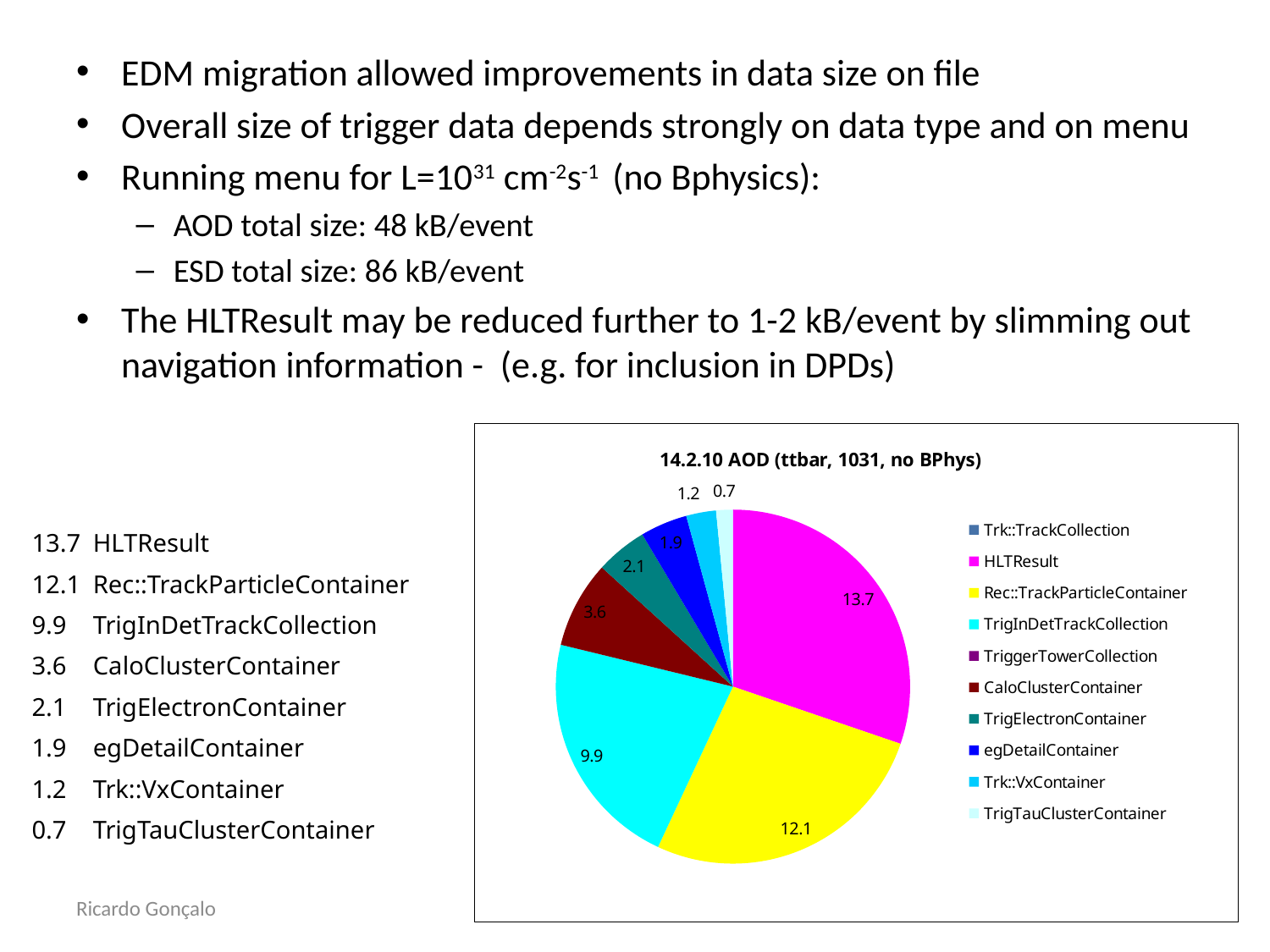
How many entries does the chart's legend list? 10 What is the difference between the values for HLTResult and Rec::TrackParticleContainer? 1.6 What is the title of the chart? 14.2.10 AOD (ttbar, 1031, no BPhys) What is the value shown for TrigTauClusterContainer in the pie chart? 0.7 What is the difference between the values for TrigInDetTrackCollection and CaloClusterContainer? 6.3 What type of chart is shown on the slide? pie chart What is the value shown for HLTResult in the pie chart? 13.7 What is the value shown for CaloClusterContainer in the pie chart? 3.6 What is the value shown for Rec::TrackParticleContainer in the pie chart? 12.1 Which category has the largest slice in the pie chart? HLTResult What is the value shown for TrigInDetTrackCollection in the pie chart? 9.9 Which is larger, the value for TrigElectronContainer or the value for egDetailContainer? TrigElectronContainer